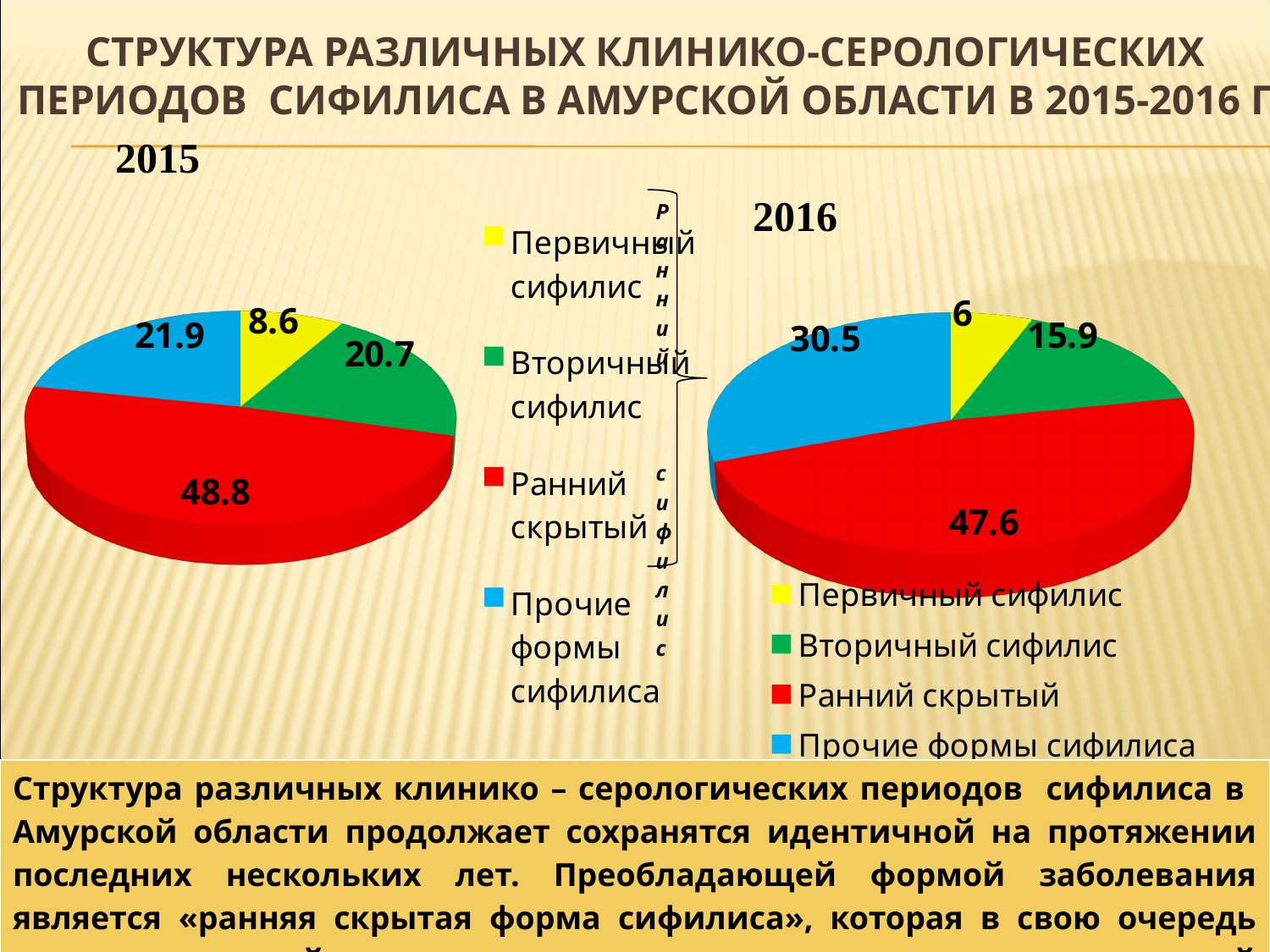
How many slices does the 2015 pie chart have? 4 In the 2015 pie chart, what is the value for Ранний скрытый? 48.8 In the 2016 pie chart, what is the value for Первичный сифилис? 6 What type of chart is used for the 2016 data? Pie chart In the 2015 pie chart, what colour is the slice for Вторичный сифилис? Green In the 2015 pie chart, what is the difference between the values for Прочие формы сифилиса and Вторичный сифилис? 1.2 In the 2016 pie chart, what is the value for Прочие формы сифилиса? 30.5 In the 2015 pie chart, which category has the largest slice? Ранний скрытый How many entries does the legend of the 2016 chart list? 4 Which is larger in the 2016 pie chart: Вторичный сифилис or Прочие формы сифилиса? Прочие формы сифилиса In the 2016 pie chart, what is the difference between the values for Ранний скрытый and Прочие формы сифилиса? 17.1 In the 2016 pie chart, which category has the smallest slice? Первичный сифилис